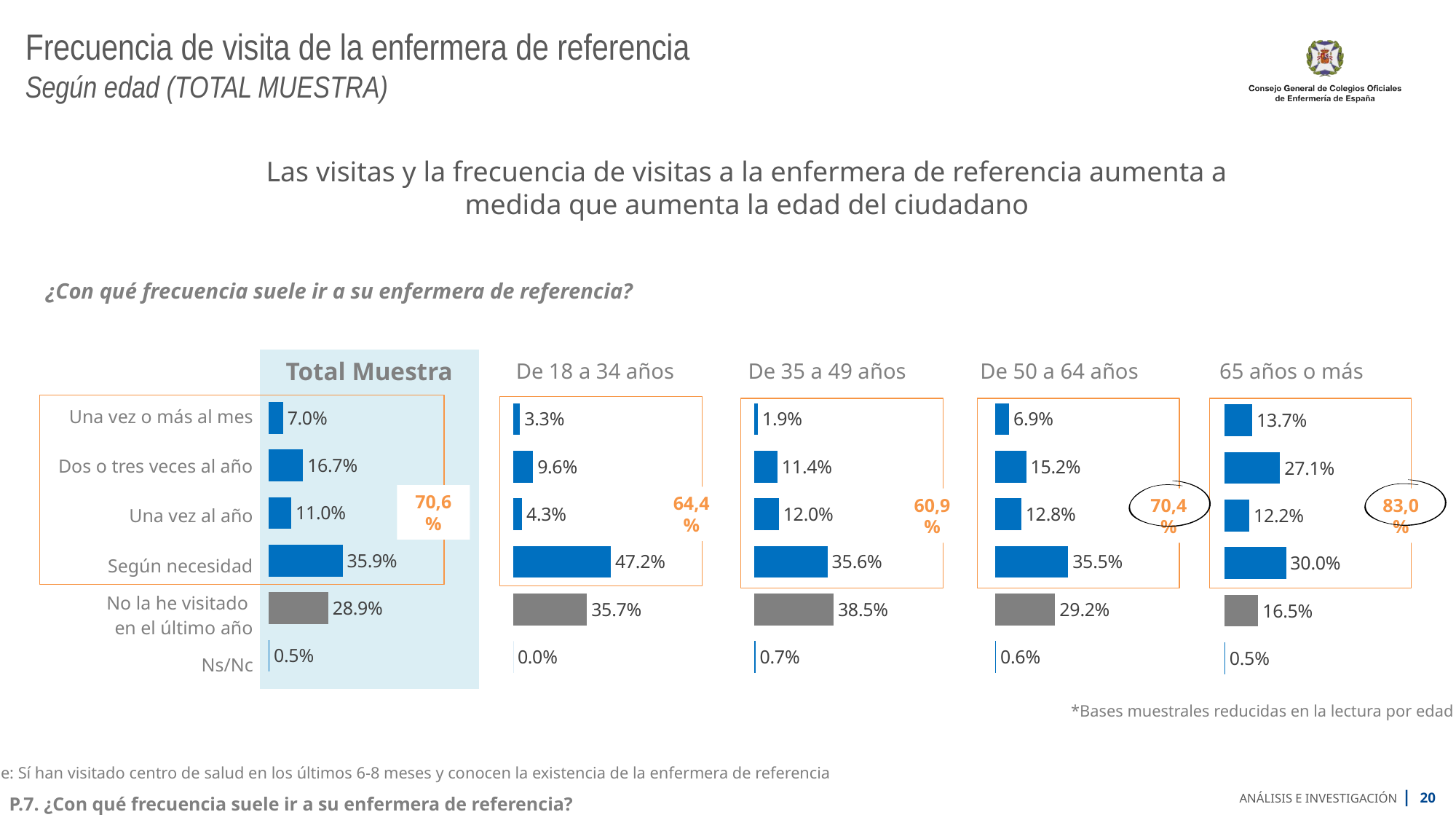
How many charts are shown on the slide? 5 In the 'De 35 a 49 años' chart, which category has the highest value? No la he visitado en el último año In the 'De 50 a 64 años' chart, which category has the lowest value? Ns/Nc How many categories does each chart on the slide show? 6 In the '65 años o más' chart, what is the difference between 'Según necesidad' and 'No la he visitado en el último año'? 13.5% Which is larger: 'Una vez o más al mes' in the 'De 18 a 34 años' chart or 'Una vez o más al mes' in the '65 años o más' chart? 65 años o más In the 'Total Muestra' chart, what is the value for 'Según necesidad'? 35.9% What kind of chart is used for the 'Total Muestra' data? Bar chart In the 'De 18 a 34 años' chart, what is the value for 'No la he visitado en el último año'? 35.7% In the 'De 18 a 34 años' chart, what is the value for 'Ns/Nc'? 0.0% In the '65 años o más' chart, what is the value for 'Dos o tres veces al año'? 27.1% In the 'De 50 a 64 años' chart, what is the difference between 'Dos o tres veces al año' and 'Una vez al año'? 2.4%